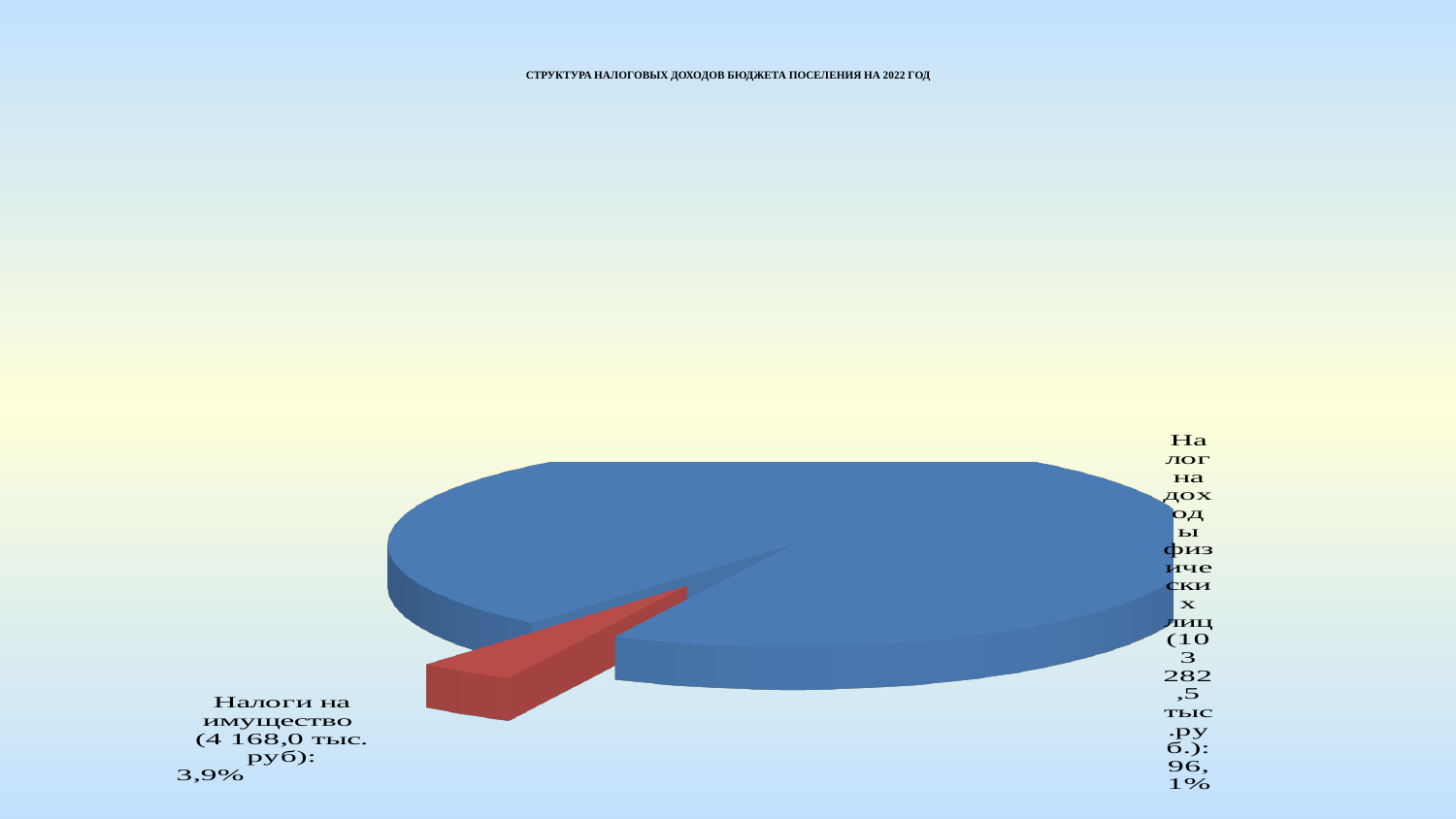
What share of the pie is Налоги на имущество? 3,9% What amount in thousand rubles is shown for Налог на доходы физических лиц? 103 282,5 тыс.руб. What kind of chart is shown on the slide? Pie chart Which category has the smallest share of the pie? Налоги на имущество Which is larger: the share for Налоги на имущество or the share for Налог на доходы физических лиц? Налог на доходы физических лиц What is the title of the chart? СТРУКТУРА НАЛОГОВЫХ ДОХОДОВ БЮДЖЕТА ПОСЕЛЕНИЯ НА 2022 ГОД How many slices does the pie chart have? 2 What share of the pie is Налог на доходы физических лиц? 96,1% What is the difference in percentage points between the share of Налог на доходы физических лиц and the share of Налоги на имущество? 92,2 What amount in thousand rubles is shown for Налоги на имущество? 4 168,0 тыс. руб What colour is the slice for Налоги на имущество? Red Which category has the largest share of the pie? Налог на доходы физических лиц